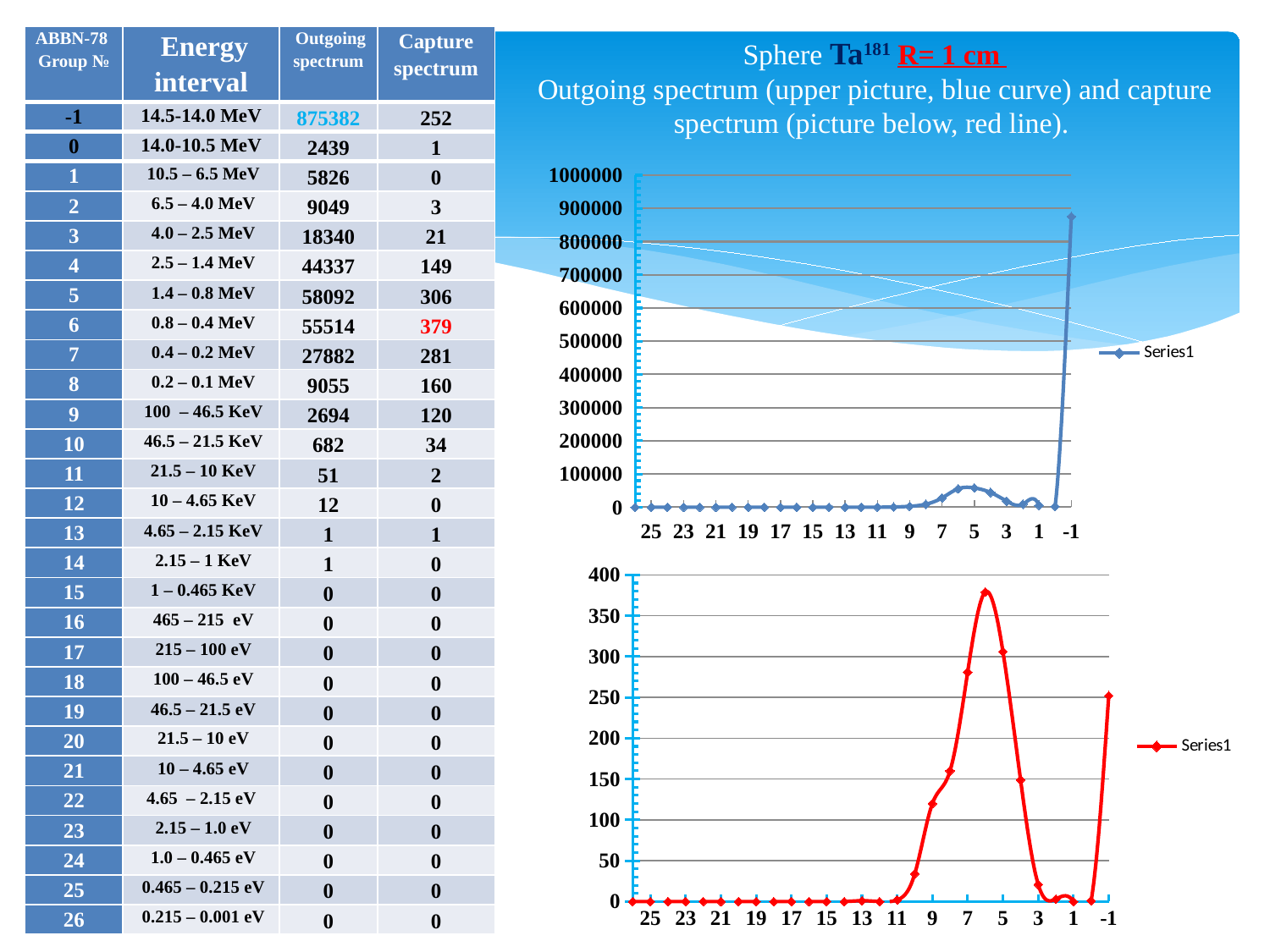
In the lower chart, is the value for group 3 greater or less than 50? less In the lower chart, is the value for group 7 greater or less than 250? greater How many series does the legend of the upper chart list? 1 What kind of chart is the upper chart on the slide? line chart What kind of chart is the lower chart on the slide? line chart What is the legend entry shown for the lower chart? Series1 In the lower chart, do the values rise or fall going from group 7 to group 3 along the x axis? fall In the upper chart, is the value for group 5 greater or less than 100000? less In the upper chart, which group on the x axis has the highest value? -1 What colour is the line in the lower chart? red